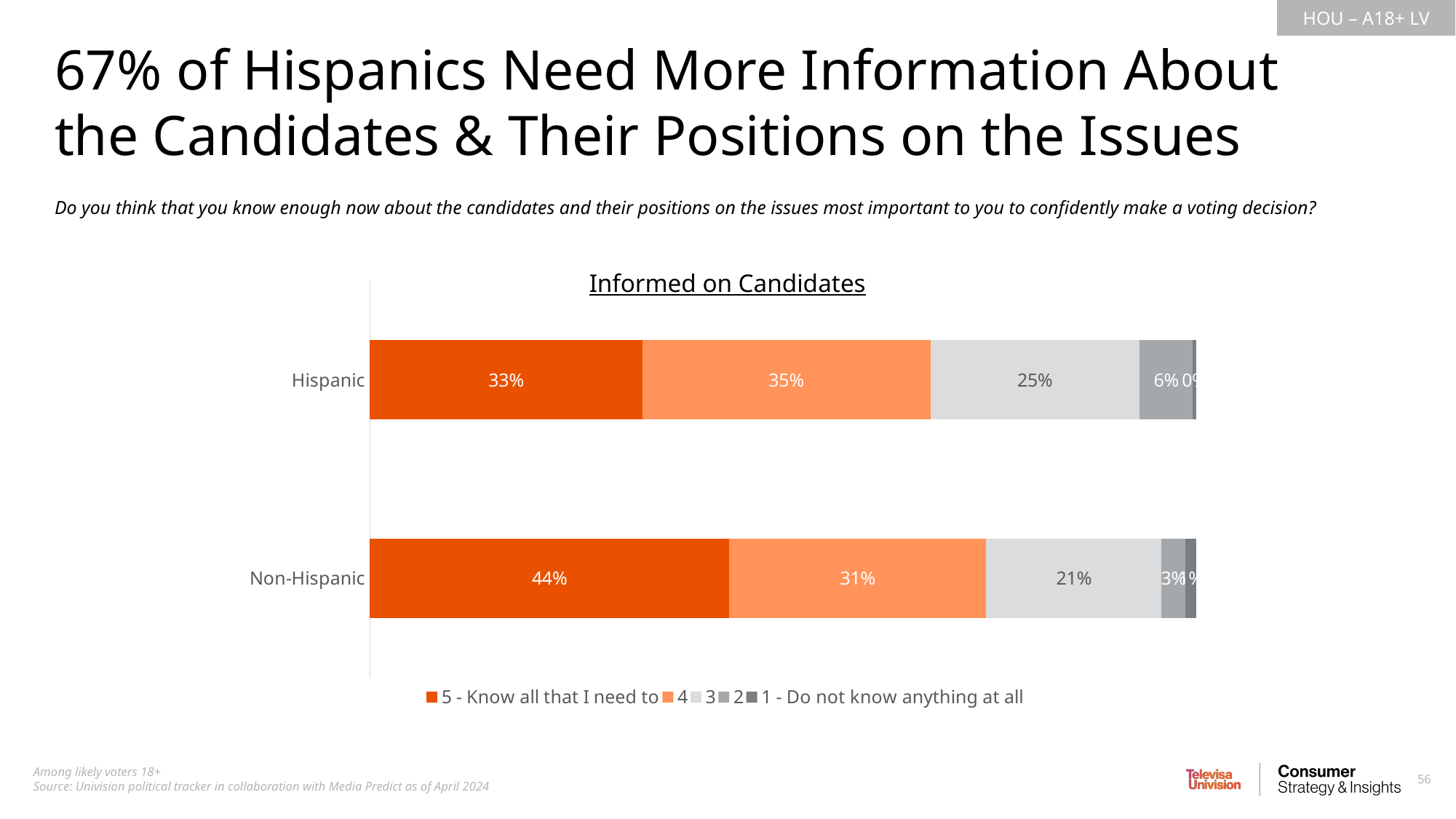
Which group has the larger share answering "5 - Know all that I need to", Hispanic or Non-Hispanic? Non-Hispanic What is the value of the "4" segment for Hispanic respondents? 35% What is the difference between the Non-Hispanic and Hispanic shares answering "5 - Know all that I need to"? 11 percentage points How many groups (bars) are shown in the chart? 2 What is the value of the "3" segment for Non-Hispanic respondents? 21% What is the value of the "2" segment for Hispanic respondents? 6% What type of chart is shown on the slide? Stacked bar chart Which response segment is the largest in the Non-Hispanic bar? 5 - Know all that I need to What percentage of Hispanic respondents answered "5 - Know all that I need to"? 33% How many series does the legend list? 5 What is the difference between the Hispanic and Non-Hispanic shares answering "4"? 4 percentage points What percentage of Non-Hispanic respondents answered "5 - Know all that I need to"? 44%